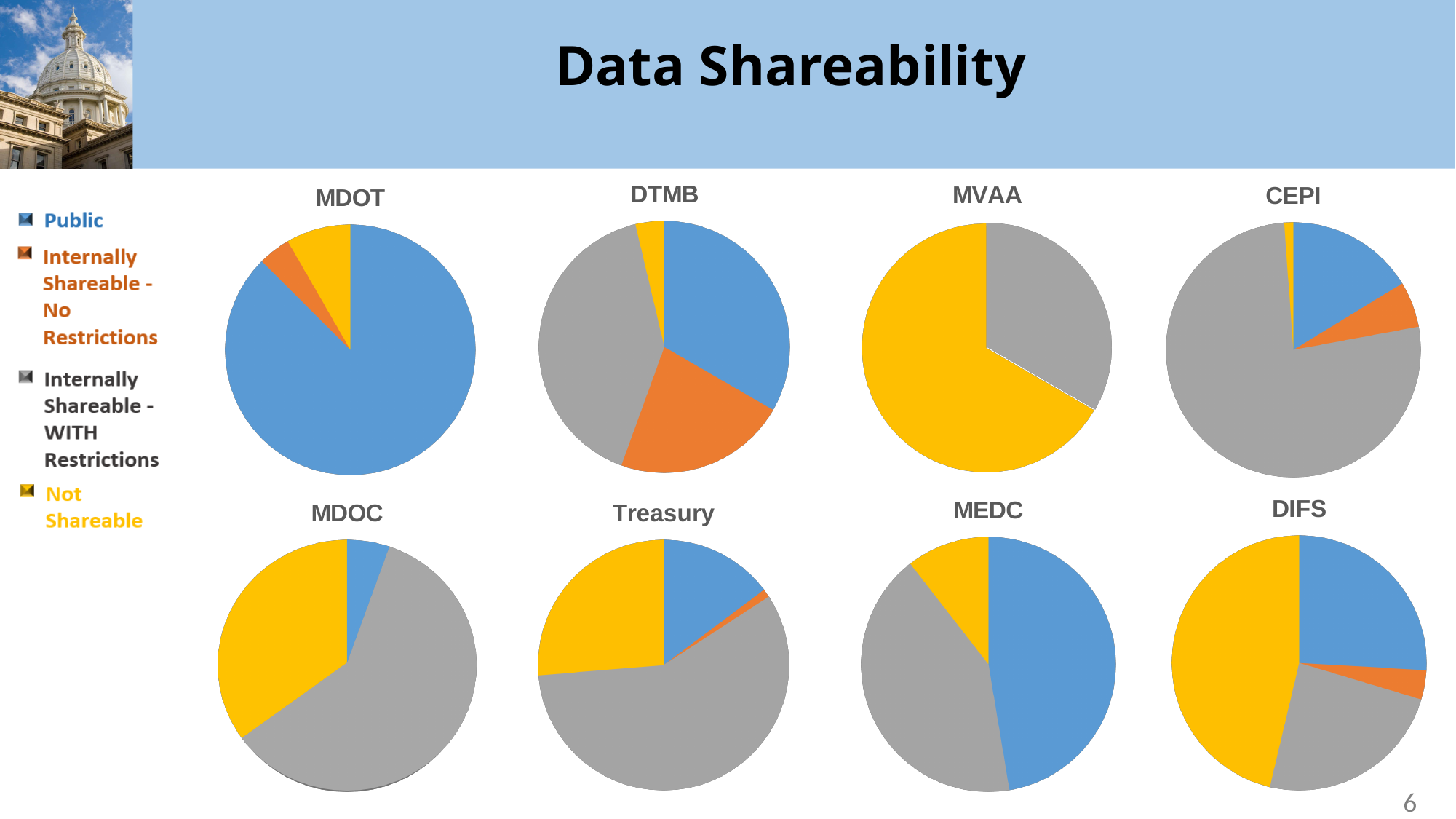
In the MVAA chart, which category has the largest slice? Not Shareable In the MVAA chart, how many slices are there? 2 How many pie charts are shown on the slide? 8 Which colour represents Public in the legend? blue In the MDOT chart, which category has the largest slice? Public What kind of chart is the MDOT chart? pie chart In the CEPI chart, which category has the largest slice? Internally Shareable - WITH Restrictions In the MDOC chart, how many slices are there? 3 In the MDOT chart, which category has the smallest slice? Internally Shareable - No Restrictions How many categories does the legend list? 4 In the MEDC chart, which is larger, Public or Not Shareable? Public